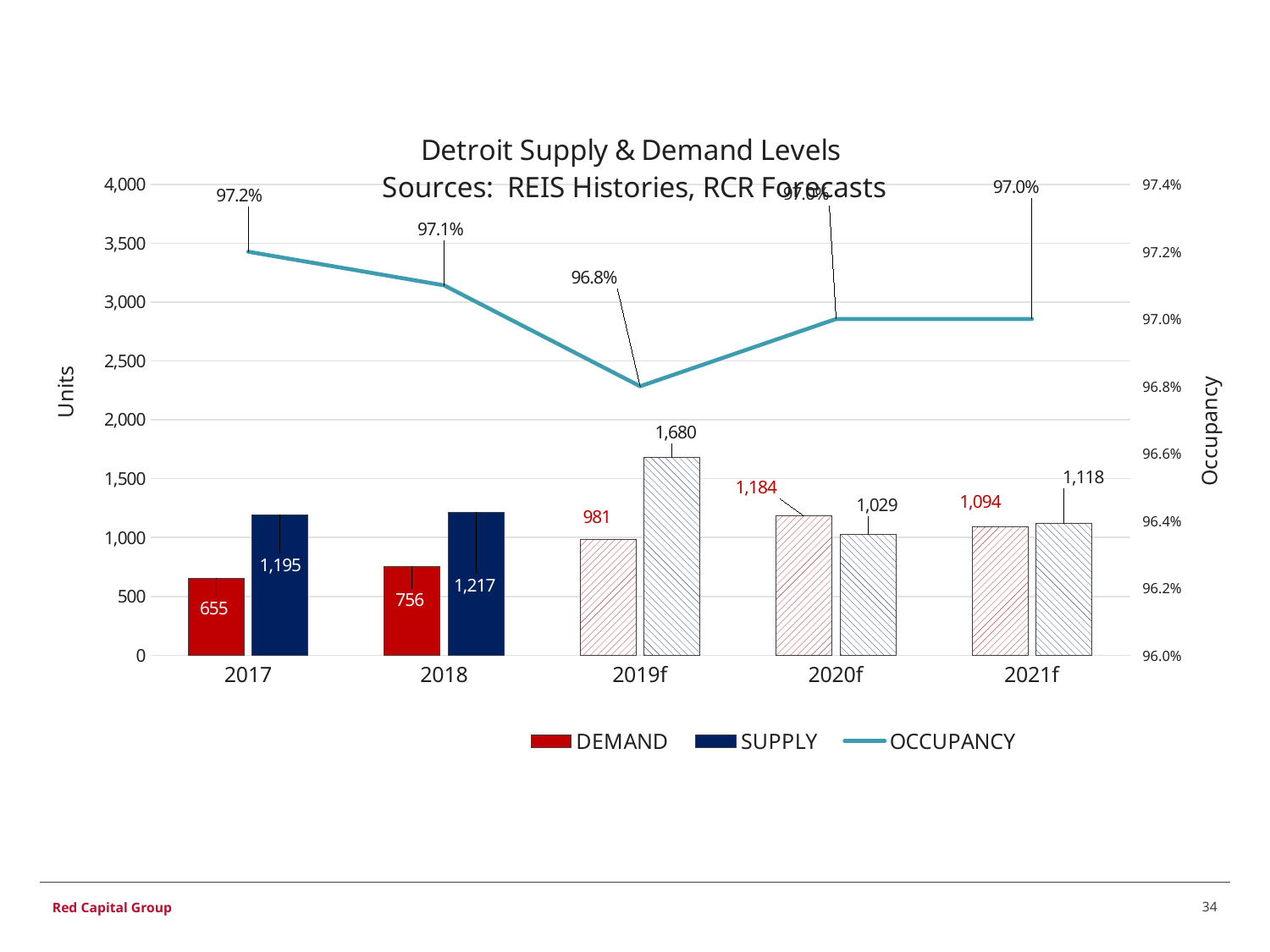
How many series does the legend list? 3 What is the OCCUPANCY value for 2018? 97.1% What is the SUPPLY value for 2019f? 1,680 How many years are shown on the x axis? 5 Which year has the lowest OCCUPANCY value? 2019f What is the difference between SUPPLY and DEMAND in 2018? 461 What kind of chart is used for the DEMAND and SUPPLY series? Bar chart Which year has the lowest DEMAND value? 2017 Which is larger in 2020f, DEMAND or SUPPLY? DEMAND Does the OCCUPANCY line rise or fall from 2017 to 2019f? Fall Which year has the highest SUPPLY value? 2019f What is the DEMAND value for 2017? 655